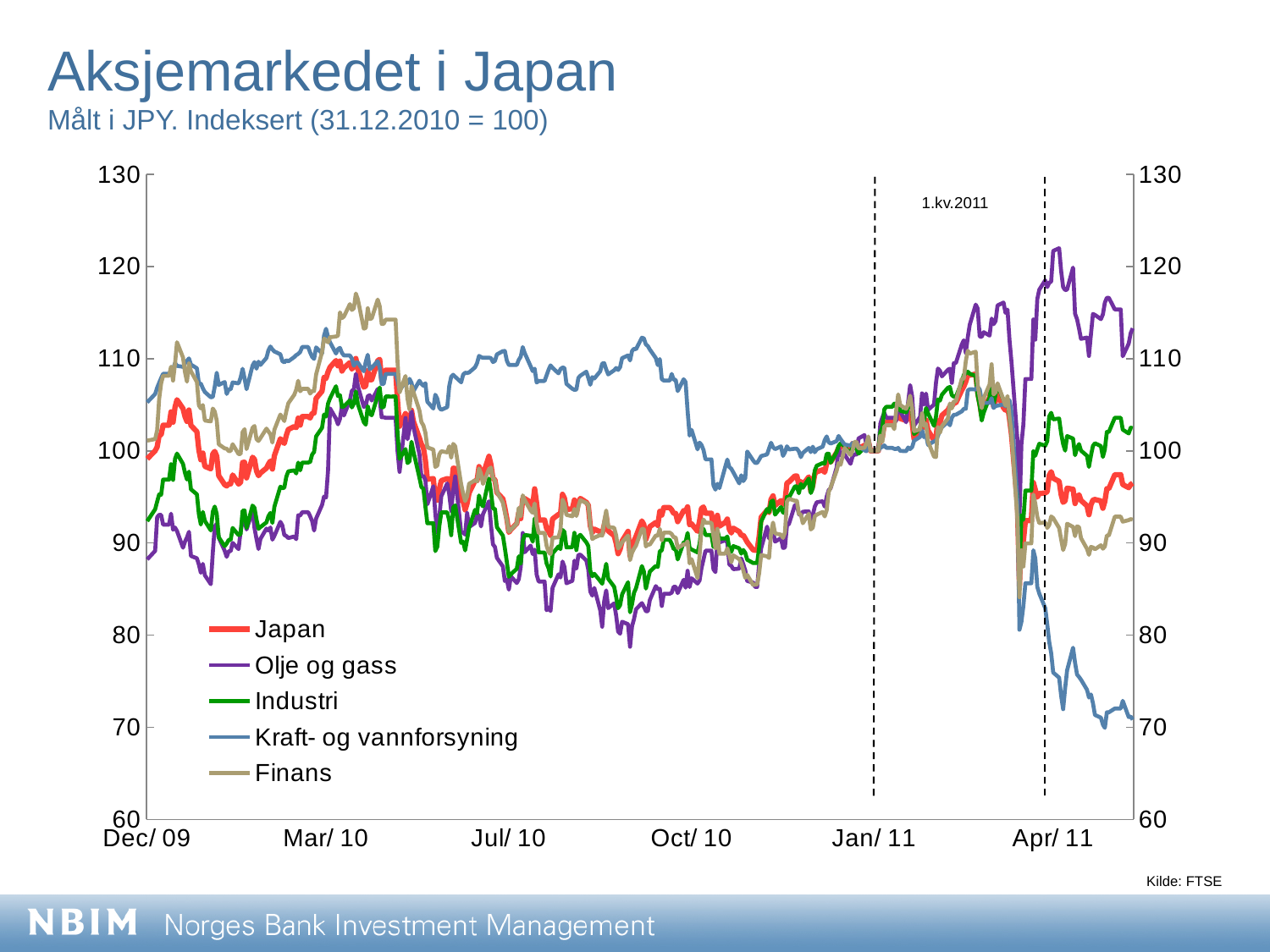
According to the subtitle, what is the index value of the series on 31.12.2010? 100 At the right end of the chart, which is larger: Olje og gass or Finans? Olje og gass Which series has the highest value at the right end of the chart (around May 2011)? Olje og gass What kind of chart is shown on the slide? Line chart What is the title of the chart? Aksjemarkedet i Japan Is the value for Olje og gass at the right end of the chart greater or less than 110? greater Does the Kraft- og vannforsyning series rise or fall between Apr/11 and the end of the chart? Fall Which series has the lowest value at the right end of the chart (around May 2011)? Kraft- og vannforsyning Is the value for Japan at the right end of the chart greater or less than 100? less What source is cited for the chart? FTSE How many series does the legend list? 5 Is the value for Kraft- og vannforsyning at the right end of the chart greater or less than 80? less